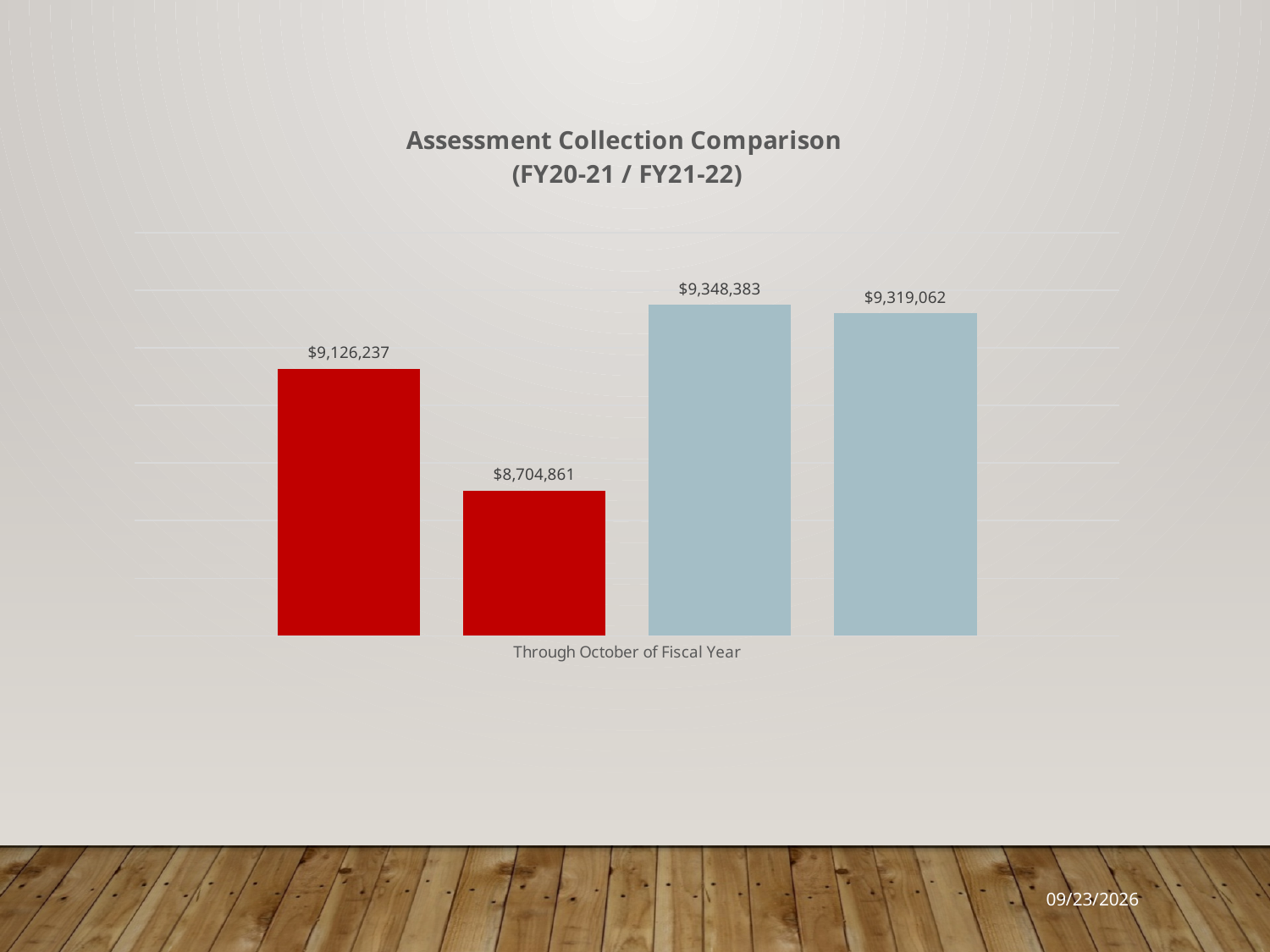
Which is larger, the value of the first bar or the value of the fourth bar? the fourth bar ($9,319,062) What is the value shown on the third bar from the left? $9,348,383 What is the value shown on the second bar from the left? $8,704,861 What is the value shown on the first (leftmost) bar? $9,126,237 What is the title of the chart? Assessment Collection Comparison (FY20-21 / FY21-22) Which bar has the lowest value? the second bar ($8,704,861) What is the difference between the first bar ($9,126,237) and the second bar ($8,704,861)? $421,376 What is the value shown on the fourth (rightmost) bar? $9,319,062 Which bar has the highest value? the third bar ($9,348,383) How many bars are plotted in the chart? 4 What text appears below the bars as the horizontal axis label? Through October of Fiscal Year What kind of chart is shown on the slide? bar chart